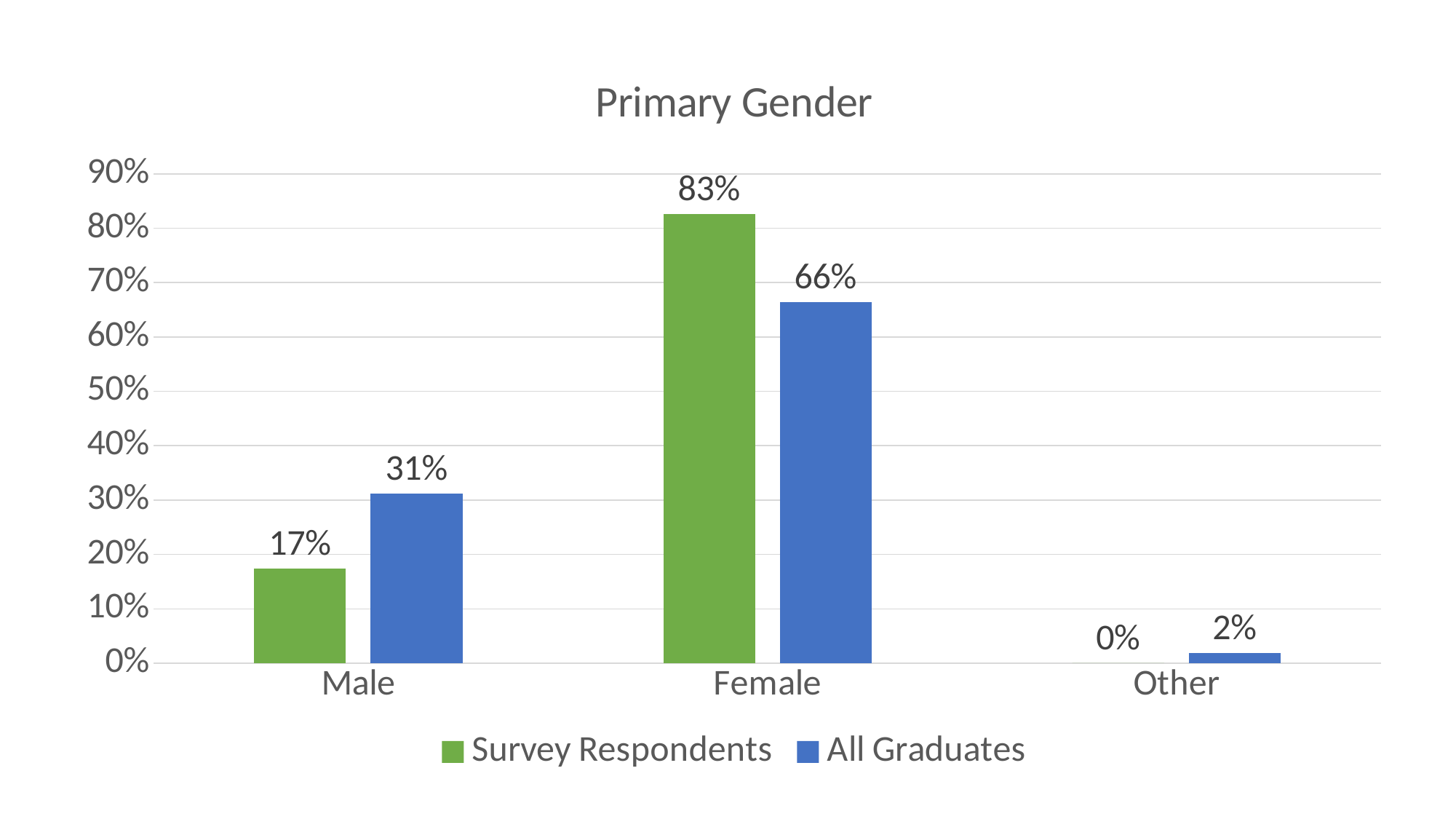
What is the Survey Respondents value for Other? 0% What is the Survey Respondents value for Female? 83% What is the difference between the Survey Respondents and All Graduates values for Female? 17% What type of chart is shown on the slide? Bar chart What is the difference between the All Graduates and Survey Respondents values for Male? 14% Which category has the highest Survey Respondents value? Female How many series does the legend list? 2 How many categories are shown on the x axis? 3 What is the All Graduates value for Male? 31% For Male, which series has the larger value: Survey Respondents or All Graduates? All Graduates What is the All Graduates value for Female? 66% Which category has the lowest All Graduates value? Other